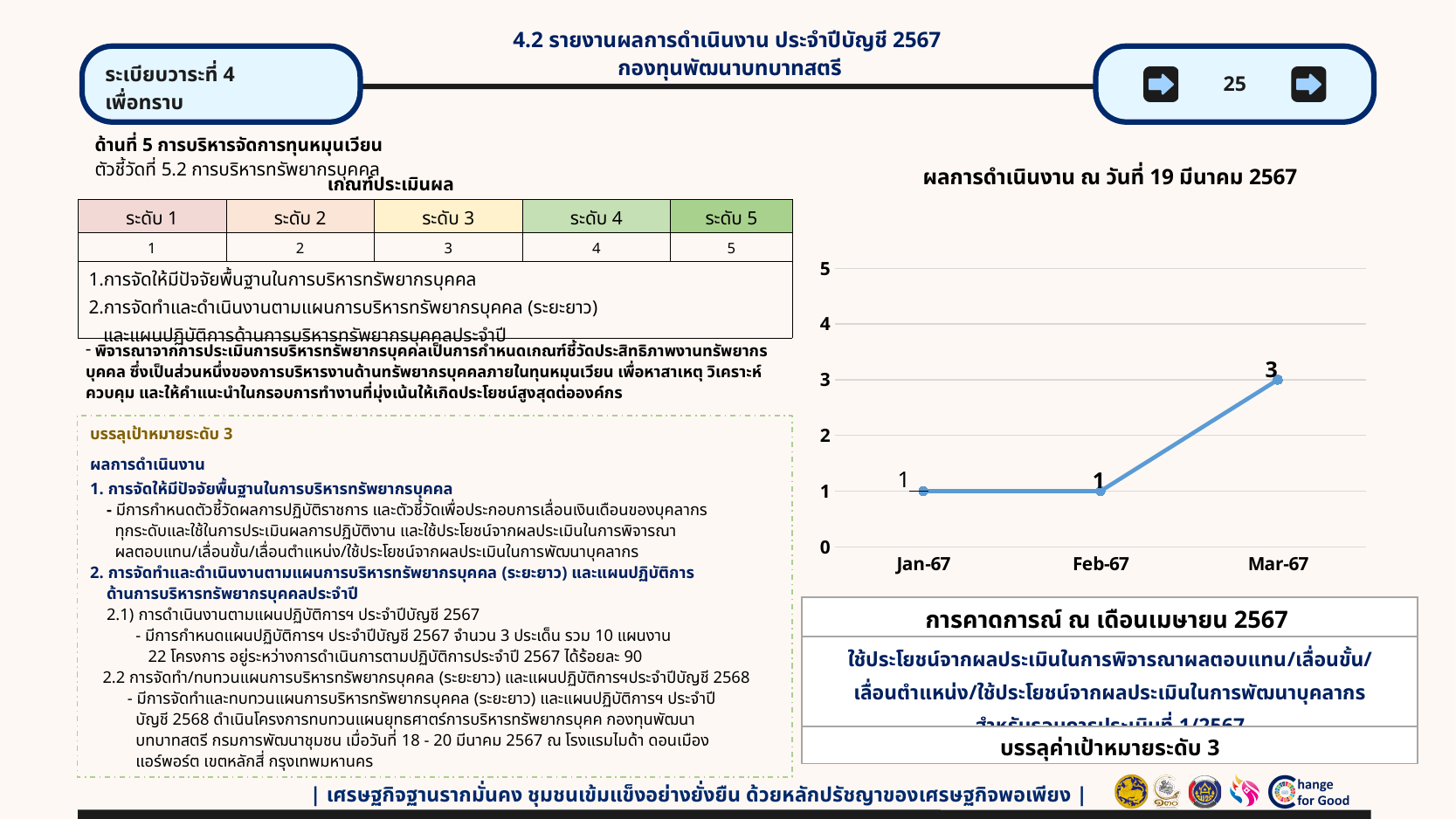
Is the value for Mar-67 in the line chart greater or less than 2? greater Does the line in the chart rise or fall from Feb-67 to Mar-67? rise What is the value for Jan-67 in the line chart? 1 Which is larger in the line chart, the value for Mar-67 or the value for Jan-67? Mar-67 How many data points are plotted in the line chart? 3 What is the value for Feb-67 in the line chart? 1 What is the difference between the values for Mar-67 and Feb-67 in the line chart? 2 What is the maximum value shown on the y-axis of the line chart? 5 What is the value for Mar-67 in the line chart? 3 Which month has the highest value in the line chart? Mar-67 What type of chart is shown on the slide? line chart What is the title of the line chart? ผลการดำเนินงาน ณ วันที่ 19 มีนาคม 2567